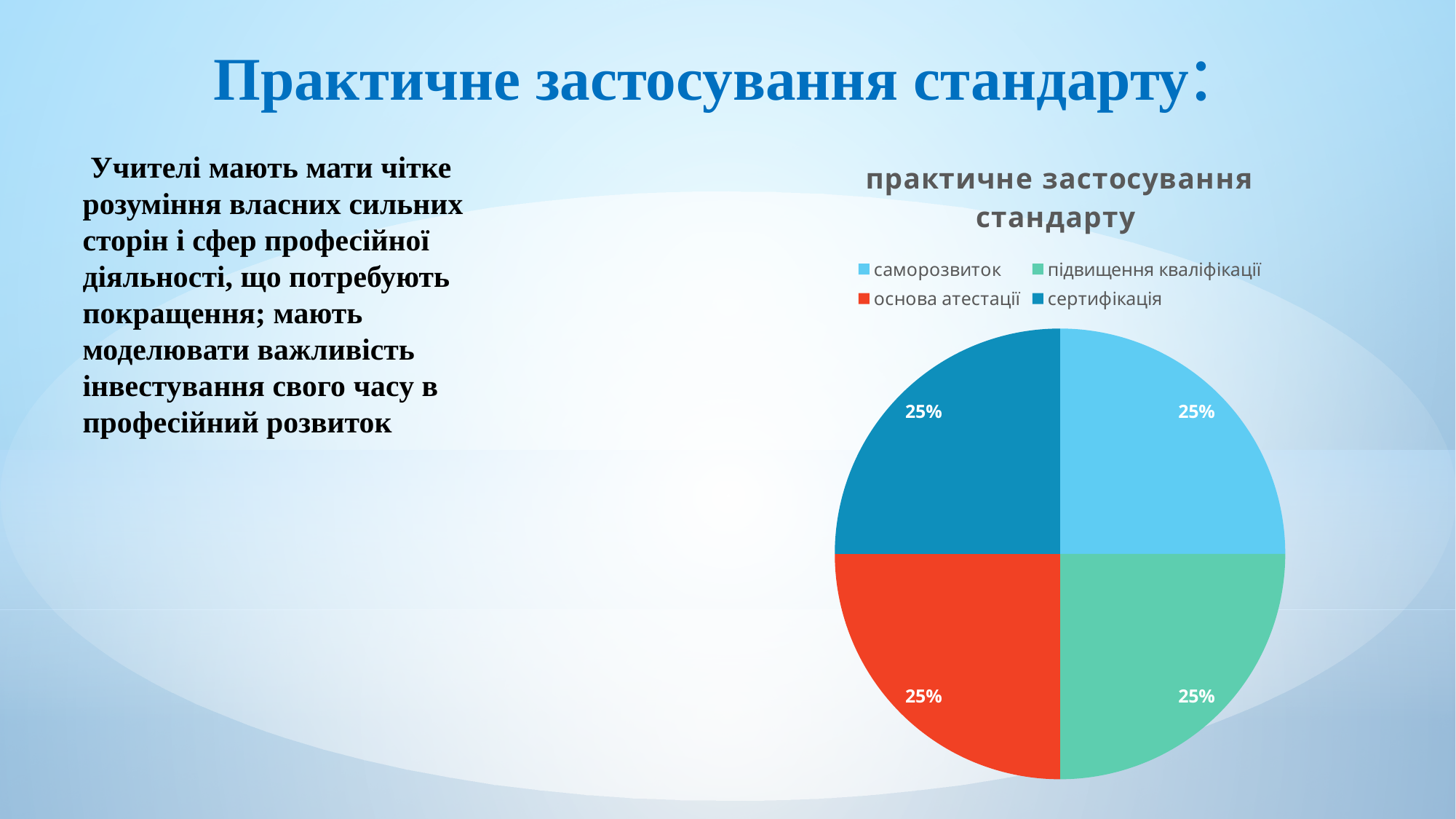
What share of the pie does саморозвиток take? 25% Do all slices of the pie chart have the same value? yes What kind of chart is shown on the slide? pie chart What is the value shown for підвищення кваліфікації? 25% What is the title of the chart? практичне застосування стандарту Which legend entry is shown in red? основа атестації What is the value shown for основа атестації? 25% How many slices does the pie chart have? 4 What share of the pie does сертифікація take? 25% What is the difference between the values for саморозвиток and сертифікація? 0% How many entries does the legend list? 4